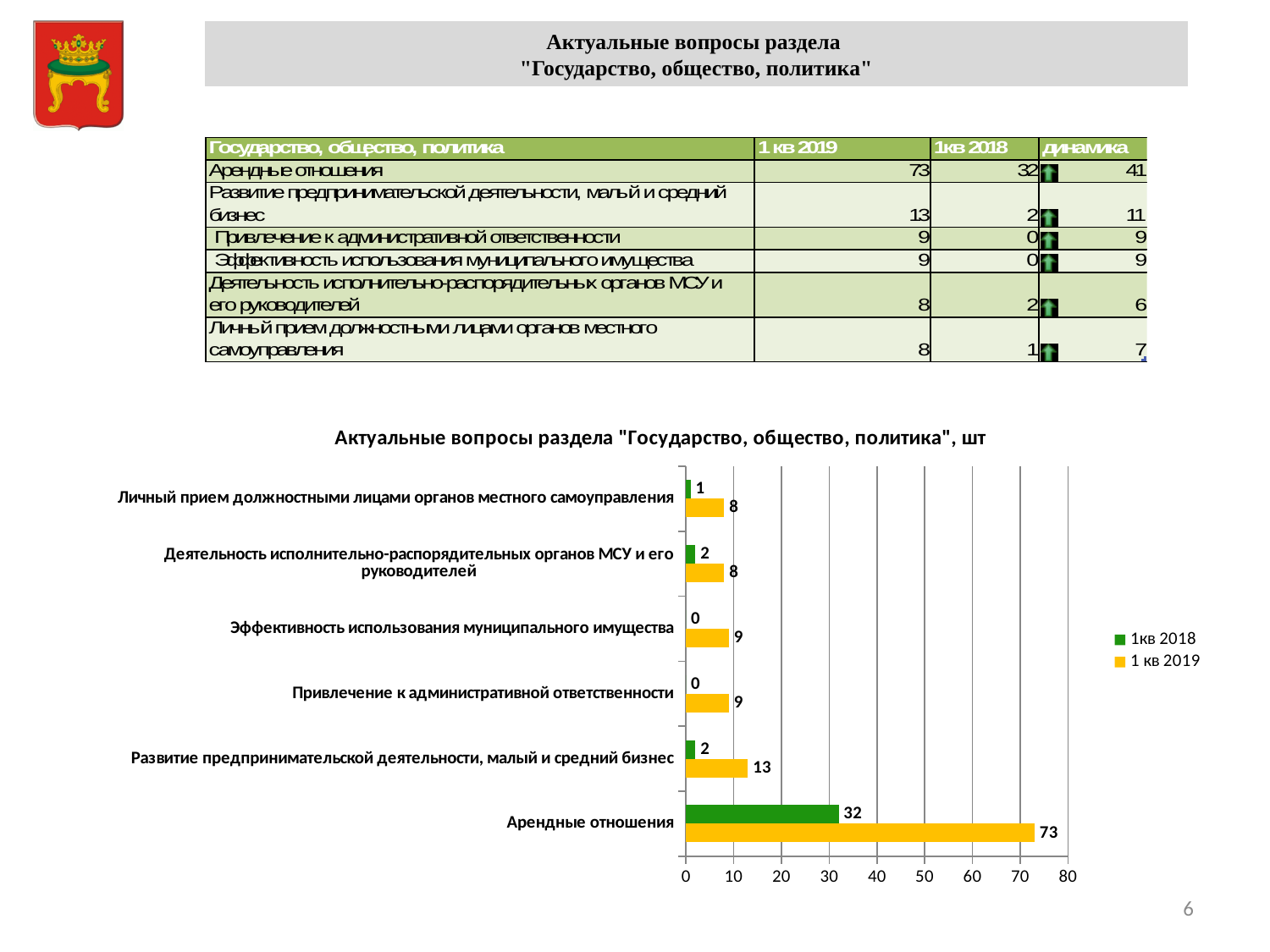
How many categories are shown on the chart? 6 How many series does the chart legend list? 2 What is the difference between the "1 кв 2019" and "1кв 2018" values for "Арендные отношения"? 41 Which category has the highest value in the "1 кв 2019" series? Арендные отношения What is the value for "Развитие предпринимательской деятельности, малый и средний бизнес" in the "1 кв 2019" series? 13 Which is larger for "Эффективность использования муниципального имущества": the "1кв 2018" value or the "1 кв 2019" value? 1 кв 2019 What is the value for "Личный прием должностными лицами органов местного самоуправления" in the "1кв 2018" series? 1 What is the value for "Арендные отношения" in the "1кв 2018" series? 32 What is the value for "Арендные отношения" in the "1 кв 2019" series? 73 What type of chart is shown on the slide? bar chart What is the difference between the "1 кв 2019" and "1кв 2018" values for "Развитие предпринимательской деятельности, малый и средний бизнес"? 11 Which series is shown in green on the chart? 1кв 2018